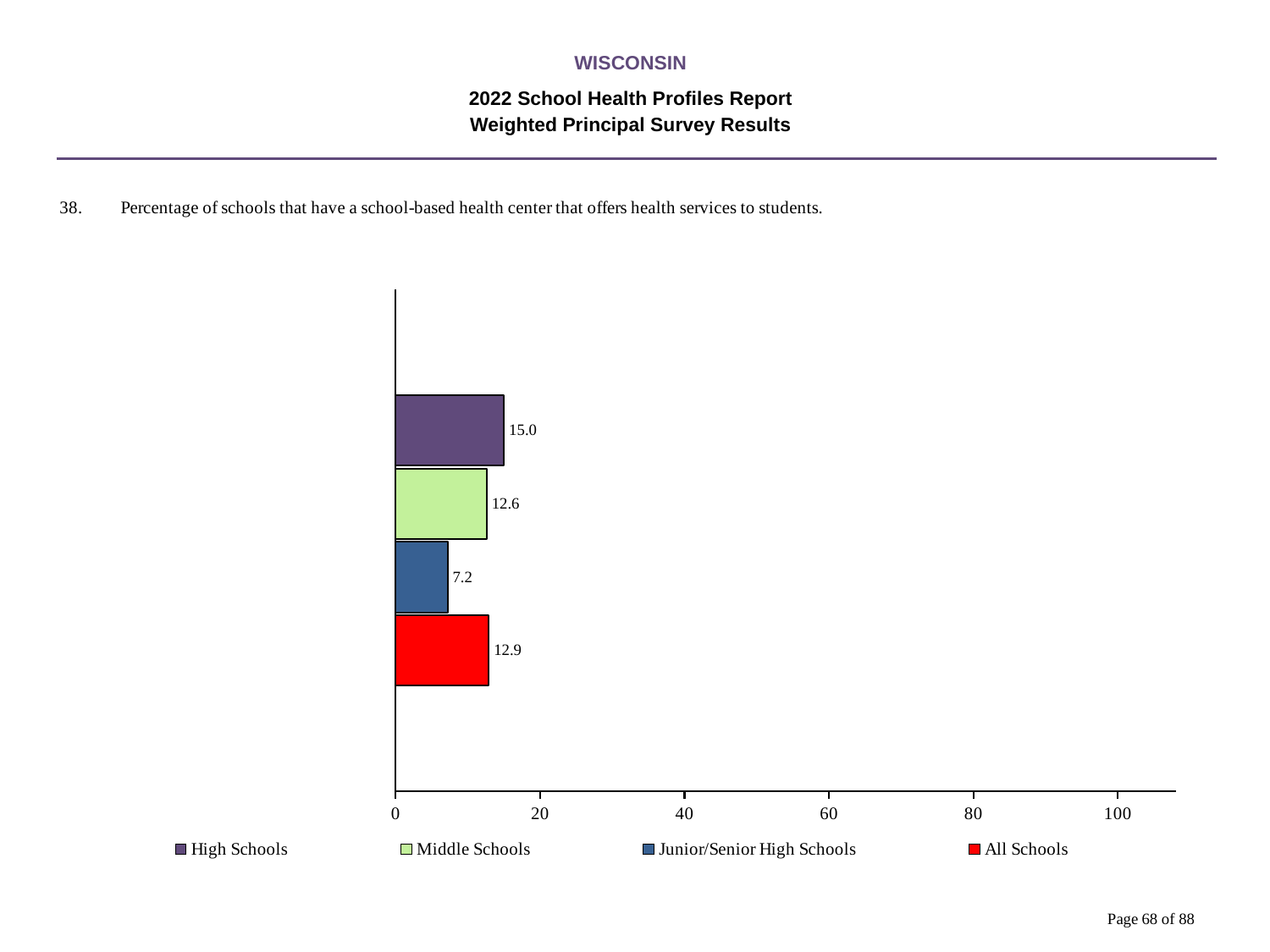
What kind of chart is shown on the slide? bar chart Is the value for High Schools greater or less than 20? less What is the difference between the High Schools value and the Junior/Senior High Schools value? 7.8 Which is larger, the value for High Schools or the value for Middle Schools? High Schools What is the value for All Schools? 12.9 What is the value for Junior/Senior High Schools? 7.2 Which school type has the lowest value? Junior/Senior High Schools What is the value for High Schools? 15.0 How many series does the legend list? 4 Which school type has the highest value? High Schools What is the value for Middle Schools? 12.6 What colour is the bar for All Schools? red